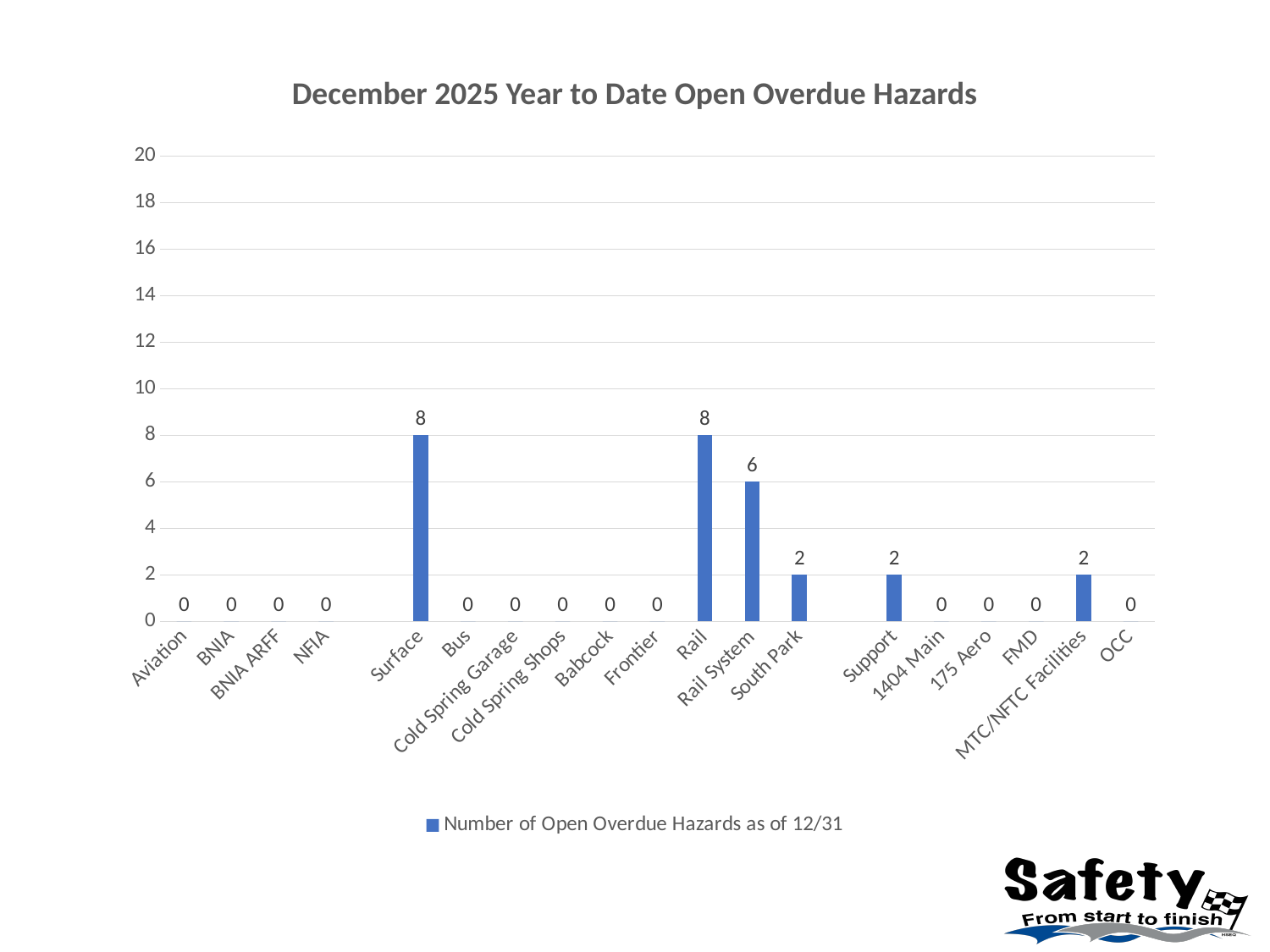
What kind of chart is shown on the slide? Bar chart What is the value shown for MTC/NFTC Facilities? 2 What is the number of open overdue hazards for Surface? 8 How many categories are shown on the x axis? 19 What is the value shown for Aviation? 0 What is the value shown for South Park? 2 How many series does the legend list? 1 What is the difference between the values for Rail and Rail System? 2 What is the number of open overdue hazards for Rail System? 6 Which two categories share the highest value on the chart? Surface and Rail What is the title of the chart? December 2025 Year to Date Open Overdue Hazards Which has a larger value, Rail System or Support? Rail System